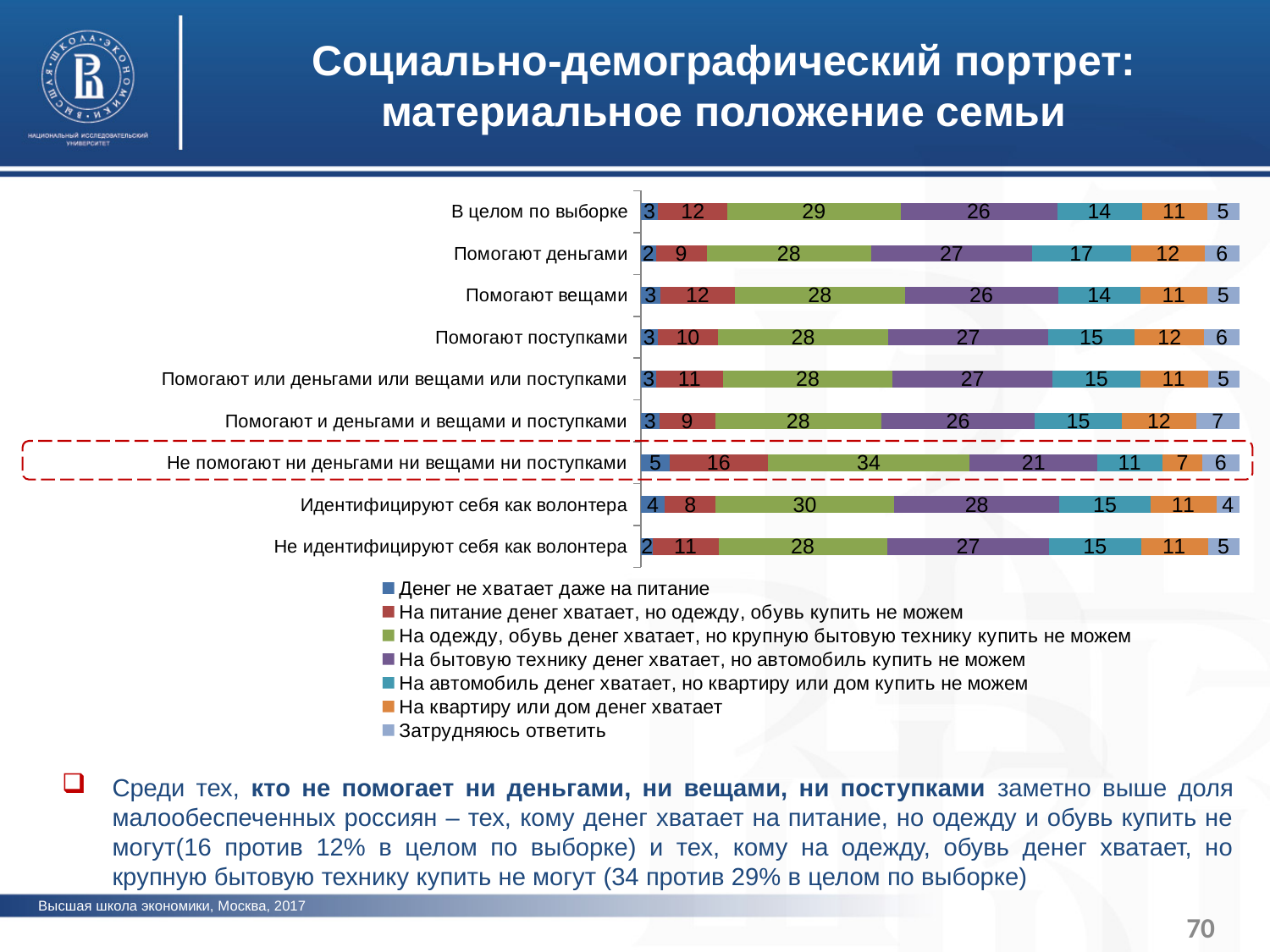
What is the total of the stacked bar for "Идентифицируют себя как волонтера"? 100 What is the value of "На питание денег хватает, но одежду, обувь купить не можем" for "В целом по выборке"? 12 What is the value of "На одежду, обувь денег хватает, но крупную бытовую технику купить не можем" for "Не помогают ни деньгами ни вещами ни поступками"? 34 Which category has the lowest value for "На бытовую технику денег хватает, но автомобиль купить не можем"? Не помогают ни деньгами ни вещами ни поступками How many series does the legend list? 7 What is the difference between the "На питание денег хватает, но одежду, обувь купить не можем" values for "Не помогают ни деньгами ни вещами ни поступками" and "В целом по выборке"? 4 What is the value of "На автомобиль денег хватает, но квартиру или дом купить не можем" for "Помогают деньгами"? 17 What type of chart is shown on the slide? Stacked bar chart How many categories (rows) does the chart show? 9 Which category has the highest value for "На одежду, обувь денег хватает, но крупную бытовую технику купить не можем"? Не помогают ни деньгами ни вещами ни поступками Which category on the chart is outlined with a red dashed box? Не помогают ни деньгами ни вещами ни поступками Which is larger: the "На квартиру или дом денег хватает" value for "Помогают деньгами" or for "Не помогают ни деньгами ни вещами ни поступками"? Помогают деньгами